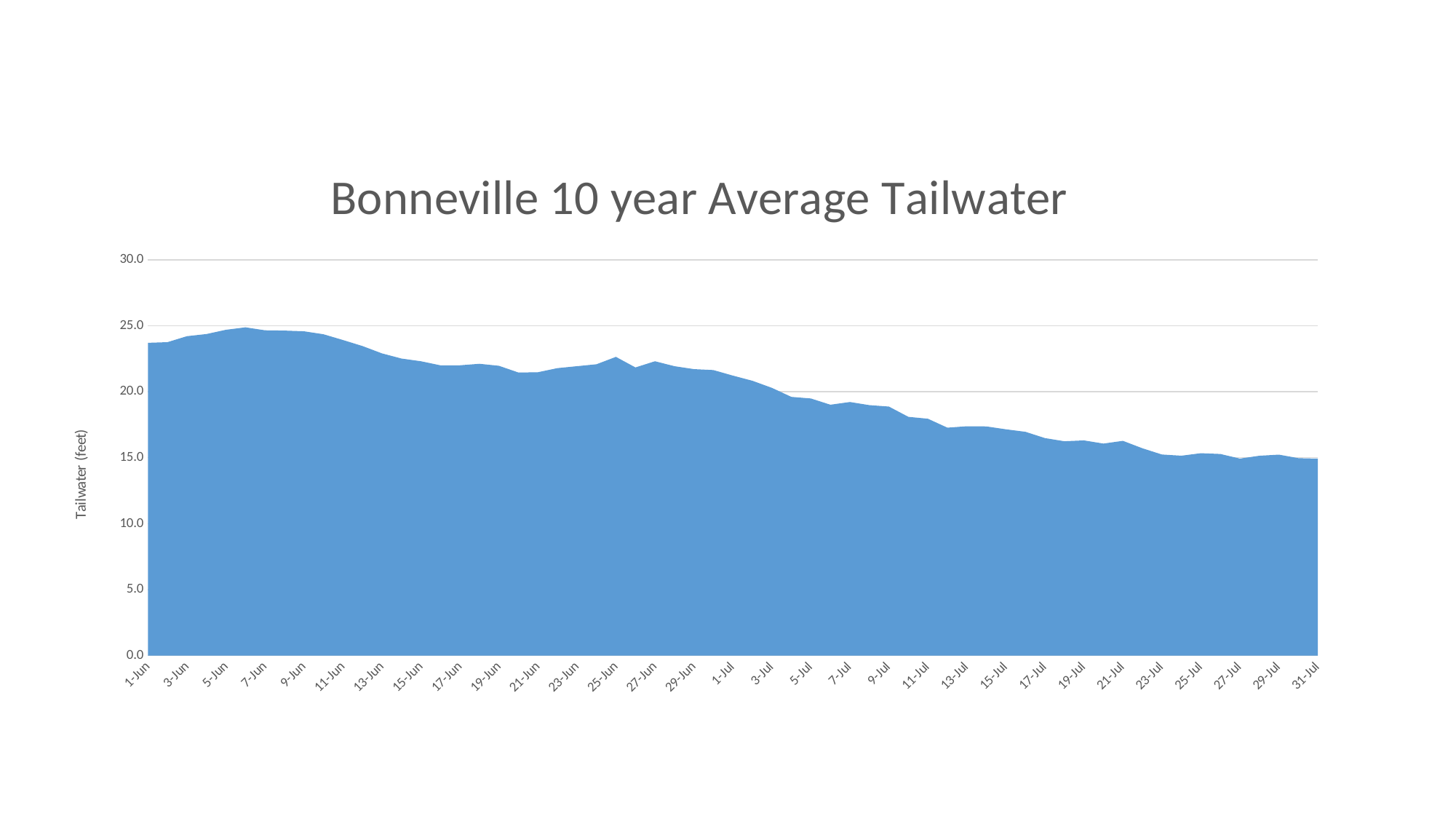
What is the label on the vertical axis of the chart? Tailwater (feet) Is the value for 1-Jun greater or less than 20.0? greater Which has the larger value, 7-Jun or 15-Jul? 7-Jun What kind of chart is shown on the slide? area chart Is the value for 7-Jun greater or less than 20.0? greater Is the value for 15-Jul greater or less than 15.0? greater Do the tailwater values generally rise or fall from 1-Jun to 31-Jul? fall What is the title of the chart? Bonneville 10 year Average Tailwater Which has the larger value, 1-Jun or 31-Jul? 1-Jun